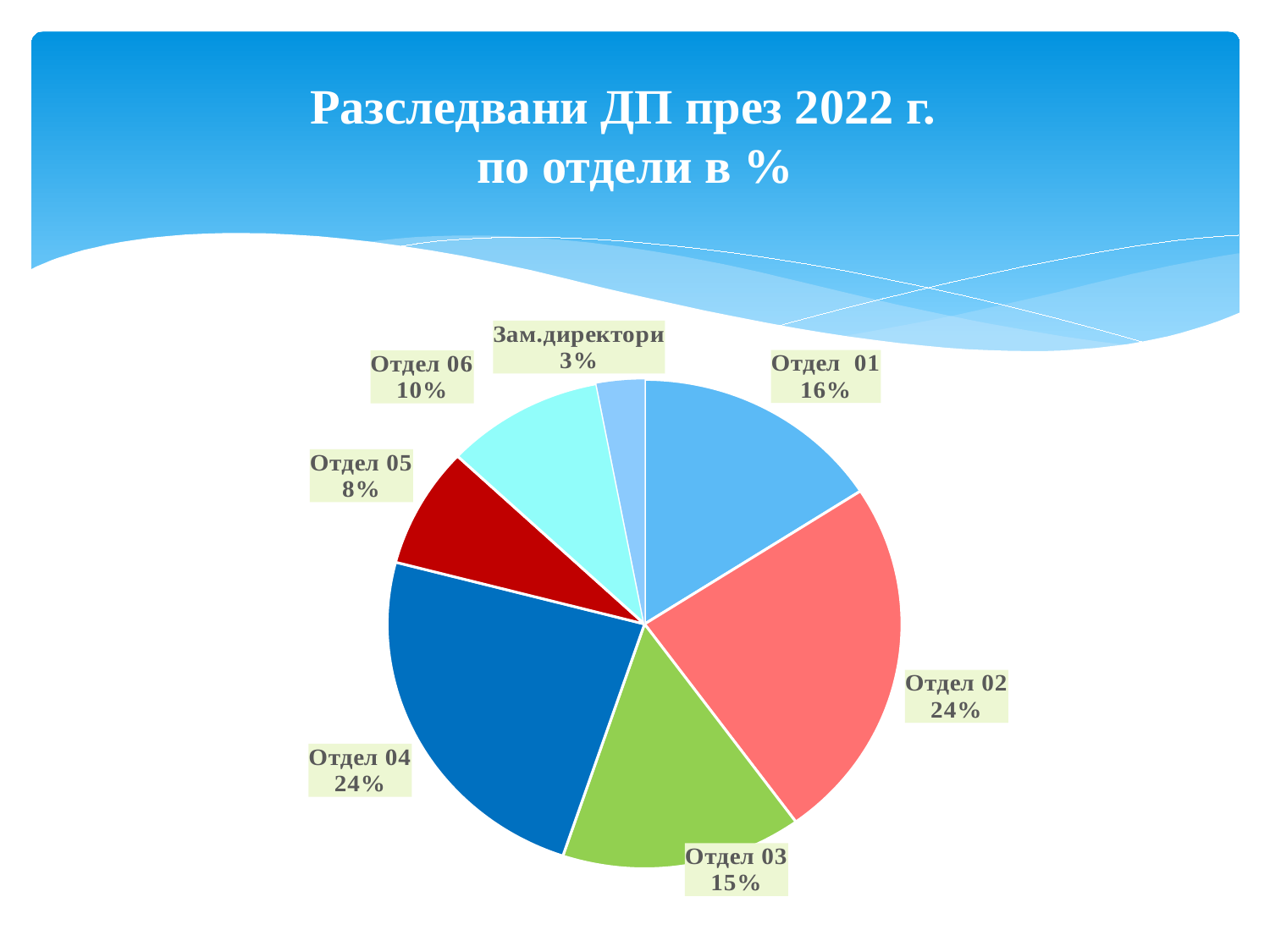
Which category has the smallest slice of the pie? Зам.директори What is the difference in percentage points between Отдел 04 and Отдел 05? 16 What is the title of the chart? Разследвани ДП през 2022 г. по отдели в % What is the combined share of Отдел 02 and Отдел 04? 48% How many slices does the pie chart have? 7 Which is larger, the slice for Отдел 01 or the slice for Отдел 06? Отдел 01 What kind of chart is shown on the slide? pie chart What is the value shown for Отдел 06? 10% What is the value shown for Отдел 05? 8% What is the value shown for Отдел 03? 15% What is the value shown for Отдел 02? 24% What share of the pie does Отдел 01 have? 16%